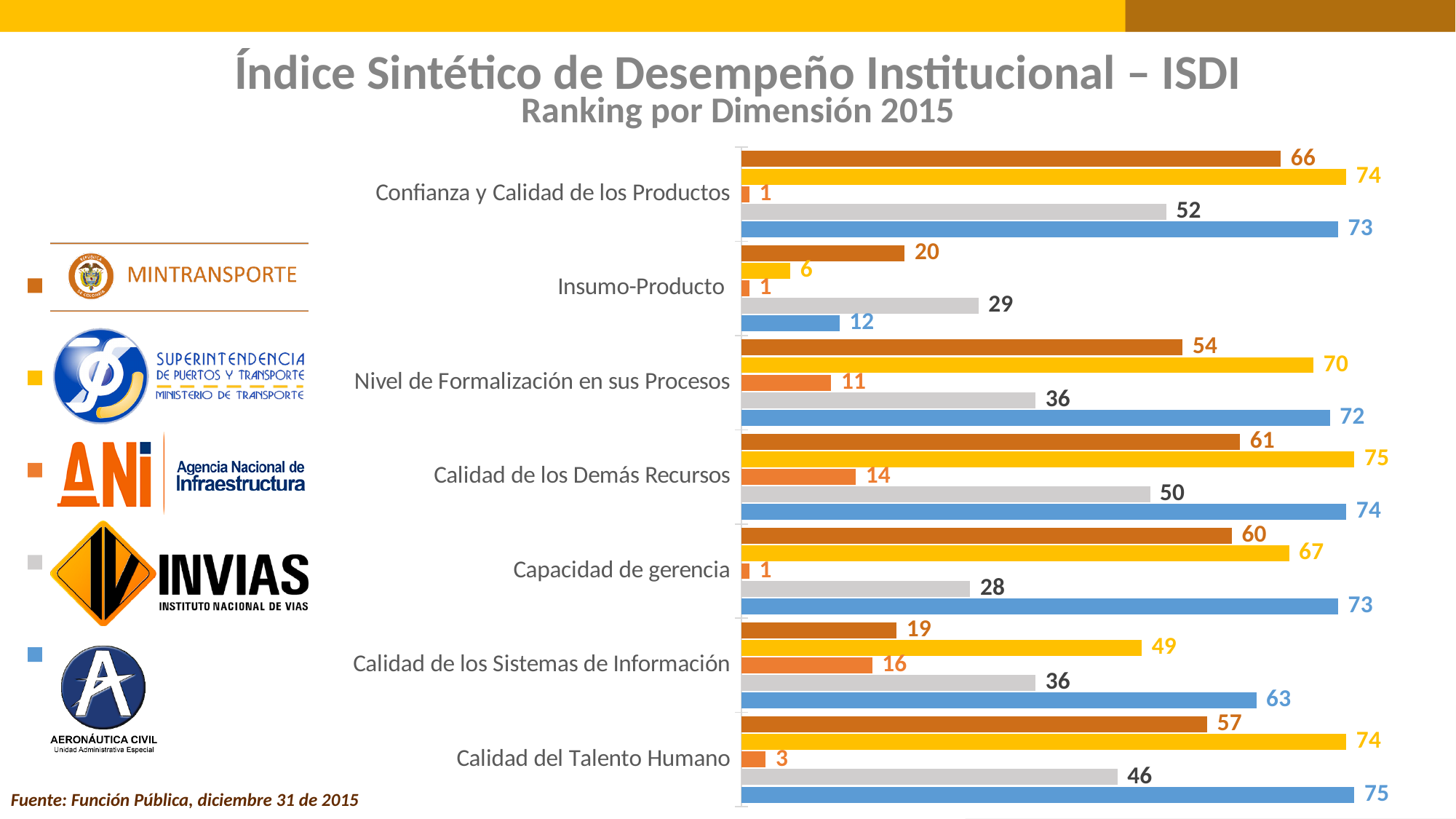
What is the value for INVIAS in Confianza y Calidad de los Productos? 52 Which entity has the lowest value in Capacidad de gerencia? ANI What kind of chart is shown on the slide? bar chart Which entity is represented by the blue bars in the chart? Aeronáutica Civil In Insumo-Producto, which is larger: the INVIAS value or the Aeronáutica Civil value? INVIAS How many dimensions (categories) are plotted on the chart? 7 How many entities (series) does the legend list? 5 Which entity has the highest value in Nivel de Formalización en sus Procesos? Aeronáutica Civil What is the value for MINTRANSPORTE in Insumo-Producto? 20 What is the value for ANI in Calidad de los Sistemas de Información? 16 What is the value for Aeronáutica Civil in Calidad del Talento Humano? 75 What is the difference between the Superintendencia de Puertos y Transporte and INVIAS values in Calidad de los Demás Recursos? 25